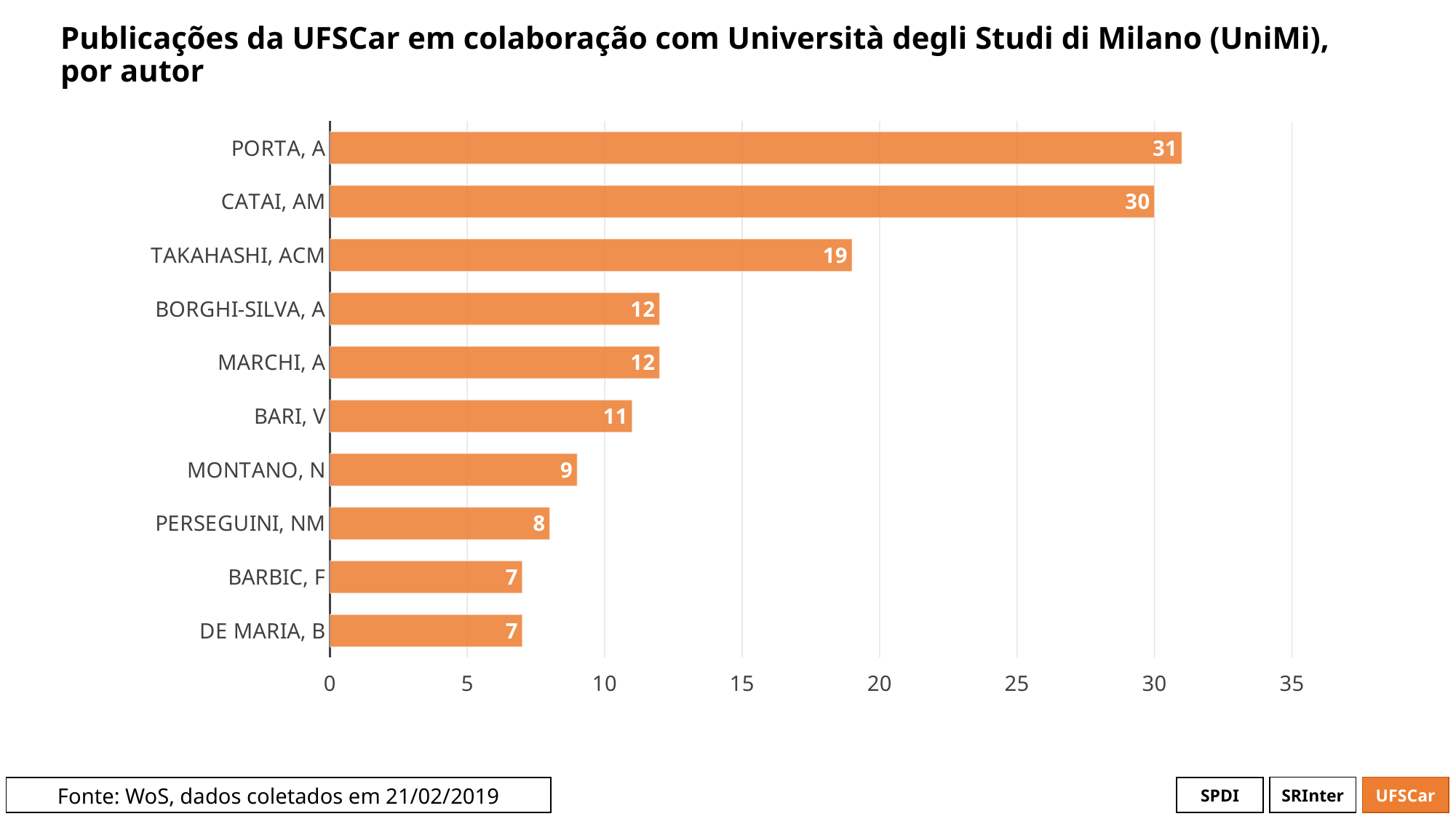
What is the difference between the values for TAKAHASHI, ACM and BARI, V? 8 What is the value shown for MONTANO, N? 9 What is the value shown for TAKAHASHI, ACM? 19 What is the source of the data cited on the slide? WoS, dados coletados em 21/02/2019 Which author has the highest number of publications? PORTA, A What is the value shown for BORGHI-SILVA, A? 12 How many publications does PORTA, A have? 31 What is the difference between the values for PORTA, A and CATAI, AM? 1 What kind of chart is shown on the slide? Bar chart Which is larger, the value for BARI, V or the value for PERSEGUINI, NM? BARI, V Is the value for CATAI, AM greater or less than 25? greater How many authors are shown in the chart? 10